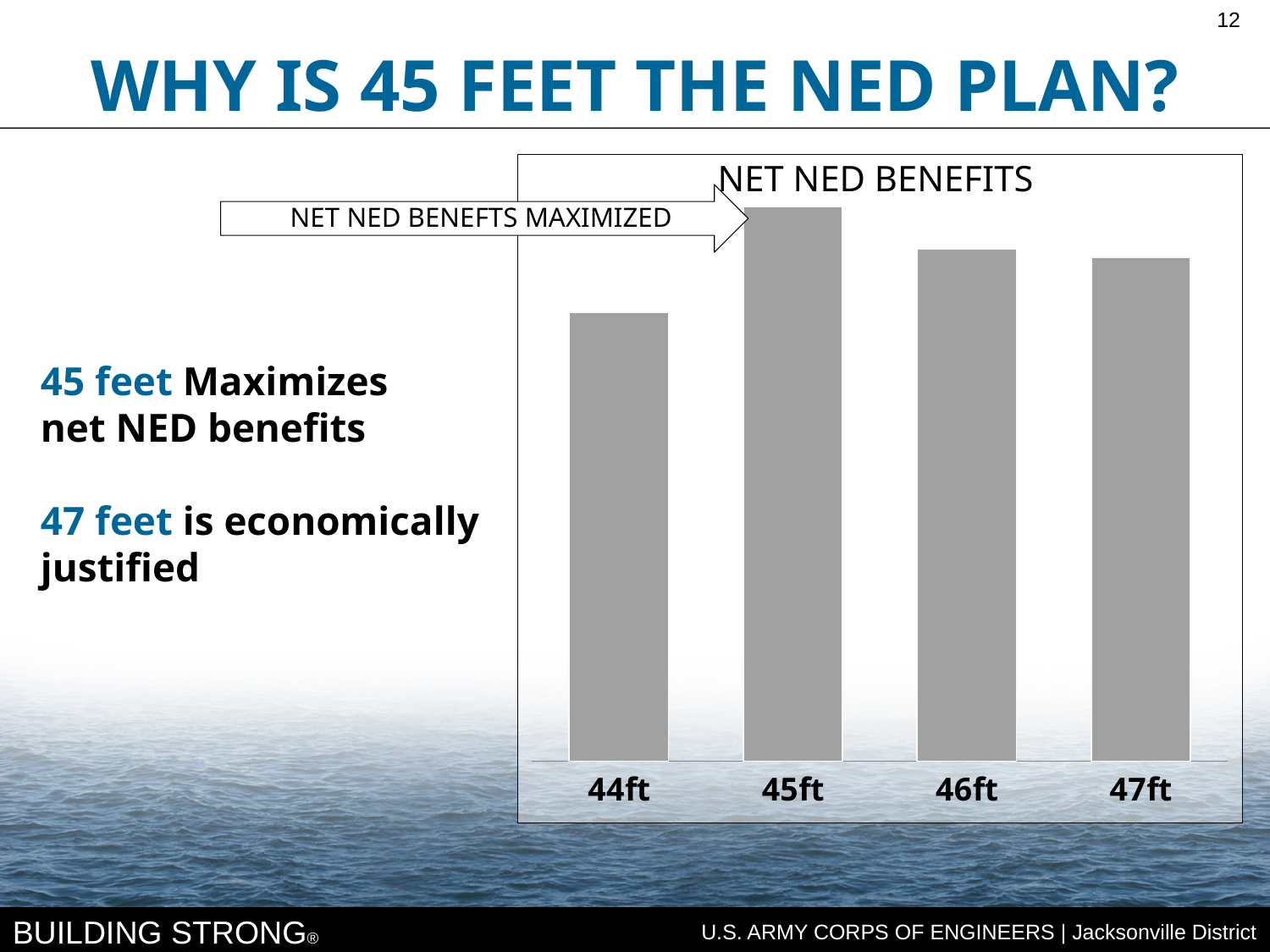
Which depth has the highest net NED benefits in the chart? 45ft Which bar is taller, 45ft or 47ft? 45ft Which depth has the lowest net NED benefits in the chart? 44ft What is the title of the chart? NET NED BENEFITS Which bar is taller, 44ft or 45ft? 45ft Which bar is taller, 44ft or 46ft? 46ft What kind of chart is shown on the slide? bar chart Do the bars rise or fall from 45ft to 47ft? fall What does the arrow annotation pointing at the 45ft bar say? NET NED BENEFTS MAXIMIZED How many bars (depth categories) does the chart show? 4 What are the category labels on the x axis of the chart, from left to right? 44ft, 45ft, 46ft, 47ft